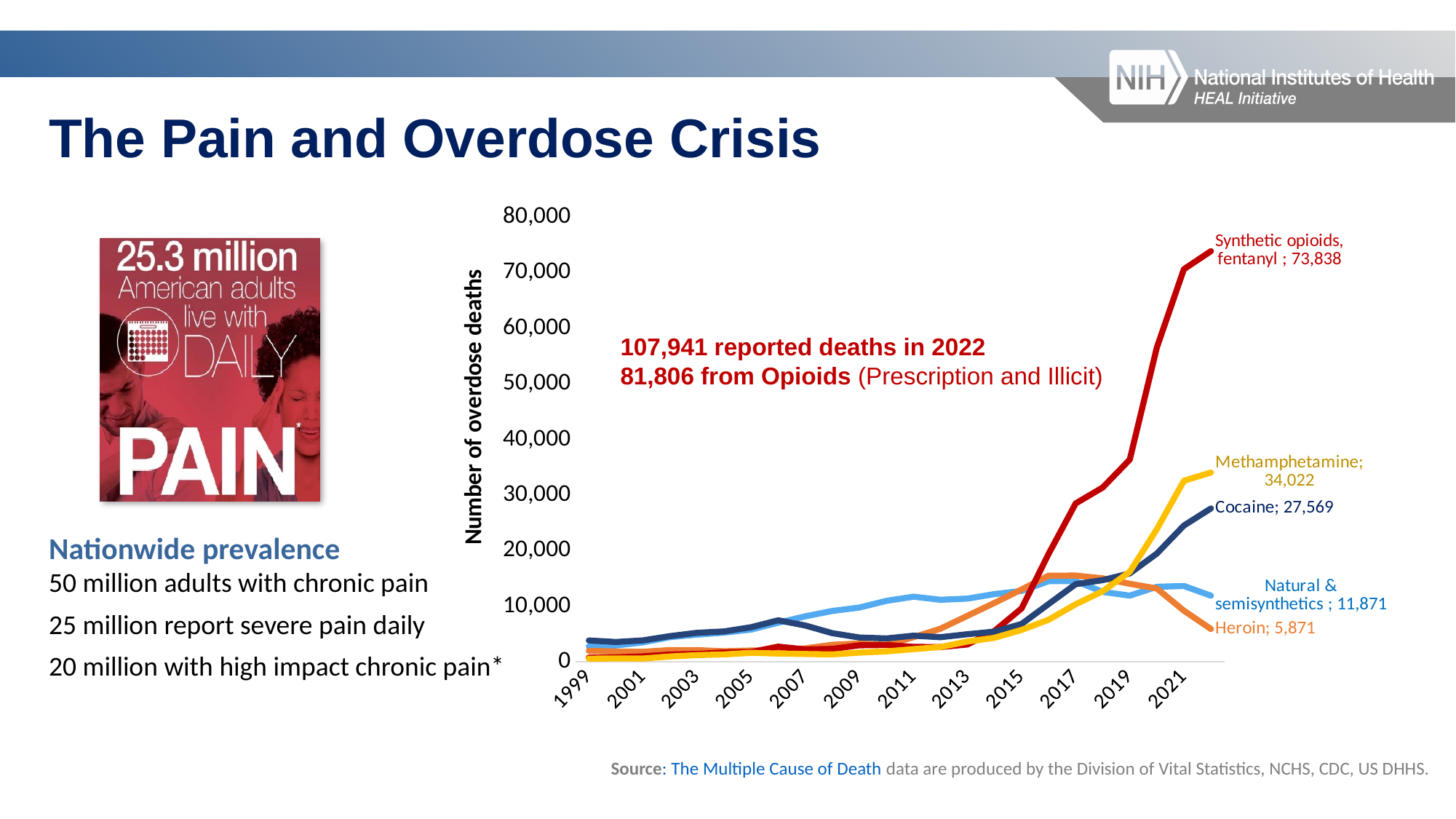
How many series are plotted on the chart? 5 What is the difference between the labelled end values for Synthetic opioids, fentanyl and Methamphetamine? 39,816 Which series has the highest labelled end value? Synthetic opioids, fentanyl Which series has the lowest labelled end value? Heroin What is the label on the vertical axis of the chart? Number of overdose deaths What is the labelled end value for the Methamphetamine line? 34,022 What is the labelled end value for the Cocaine line? 27,569 What is the labelled end value for the Synthetic opioids, fentanyl line? 73,838 Is the value for Synthetic opioids, fentanyl in 2021 greater or less than 60,000? greater Which has the larger labelled end value, Cocaine or Natural & semisynthetics? Cocaine What kind of chart is shown on the slide? line chart What is the labelled end value for the Heroin line? 5,871